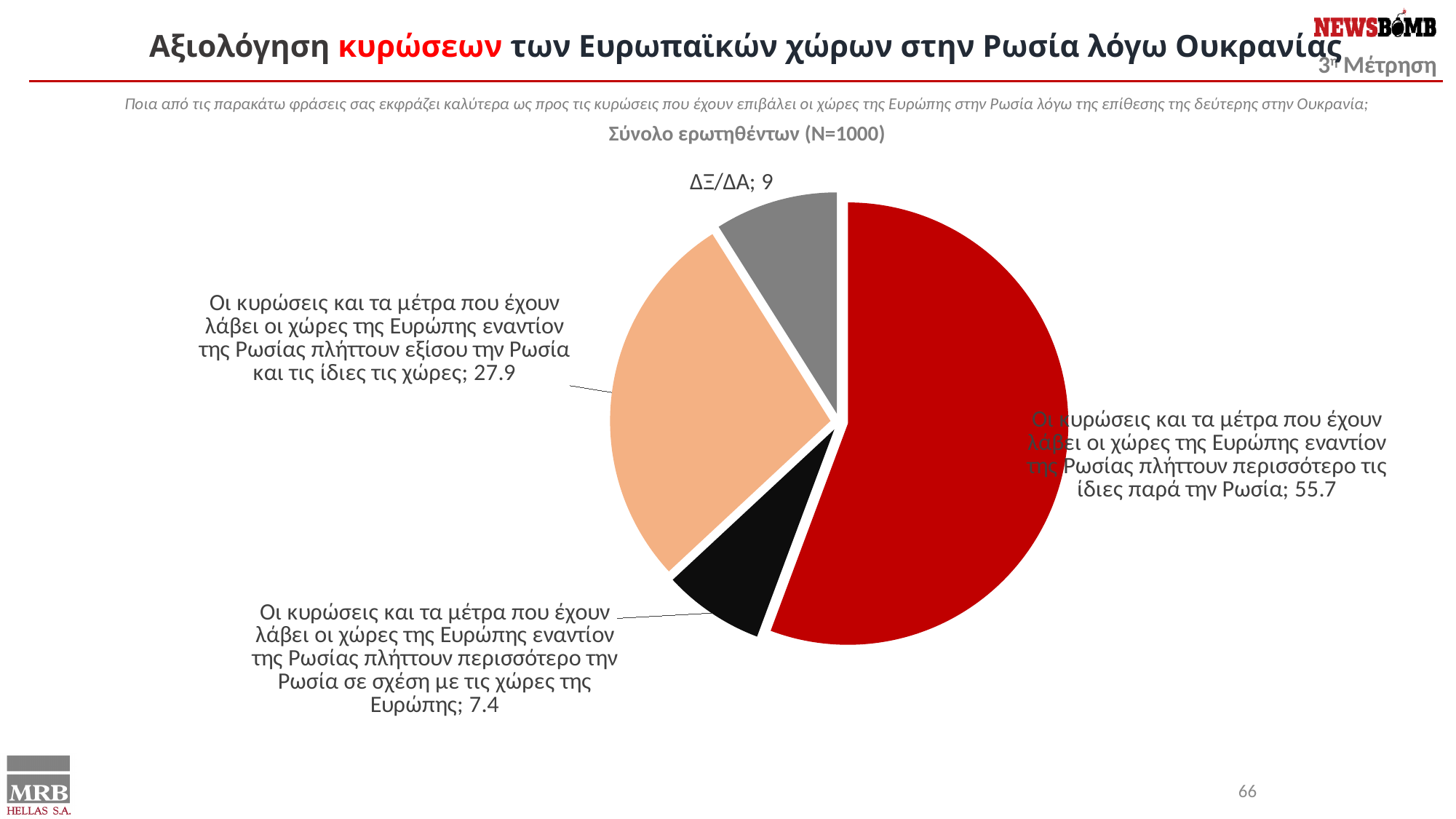
What is the difference between the value for 'πλήττουν περισσότερο τις ίδιες παρά την Ρωσία' and the value for 'πλήττουν εξίσου την Ρωσία και τις ίδιες τις χώρες'? 27.8 What is the value for the slice 'Οι κυρώσεις και τα μέτρα που έχουν λάβει οι χώρες της Ευρώπης εναντίον της Ρωσίας πλήττουν εξίσου την Ρωσία και τις ίδιες τις χώρες'? 27.9 What kind of chart is shown on the slide? Pie chart What colour is the slice for 'ΔΞ/ΔΑ'? Grey What is the value for the slice 'Οι κυρώσεις και τα μέτρα που έχουν λάβει οι χώρες της Ευρώπης εναντίον της Ρωσίας πλήττουν περισσότερο τις ίδιες παρά την Ρωσία'? 55.7 What is the sample size (N) stated above the pie chart? N=1000 Which slice of the pie chart is the smallest? Οι κυρώσεις και τα μέτρα που έχουν λάβει οι χώρες της Ευρώπης εναντίον της Ρωσίας πλήττουν περισσότερο την Ρωσία σε σχέση με τις χώρες της Ευρώπης How many slices does the pie chart have? 4 What is the value for the slice 'ΔΞ/ΔΑ'? 9 What is the value for the slice 'Οι κυρώσεις και τα μέτρα που έχουν λάβει οι χώρες της Ευρώπης εναντίον της Ρωσίας πλήττουν περισσότερο την Ρωσία σε σχέση με τις χώρες της Ευρώπης'? 7.4 Which slice of the pie chart is the largest? Οι κυρώσεις και τα μέτρα που έχουν λάβει οι χώρες της Ευρώπης εναντίον της Ρωσίας πλήττουν περισσότερο τις ίδιες παρά την Ρωσία Which is larger: the value for 'ΔΞ/ΔΑ' or the value for 'πλήττουν περισσότερο την Ρωσία σε σχέση με τις χώρες της Ευρώπης'? ΔΞ/ΔΑ